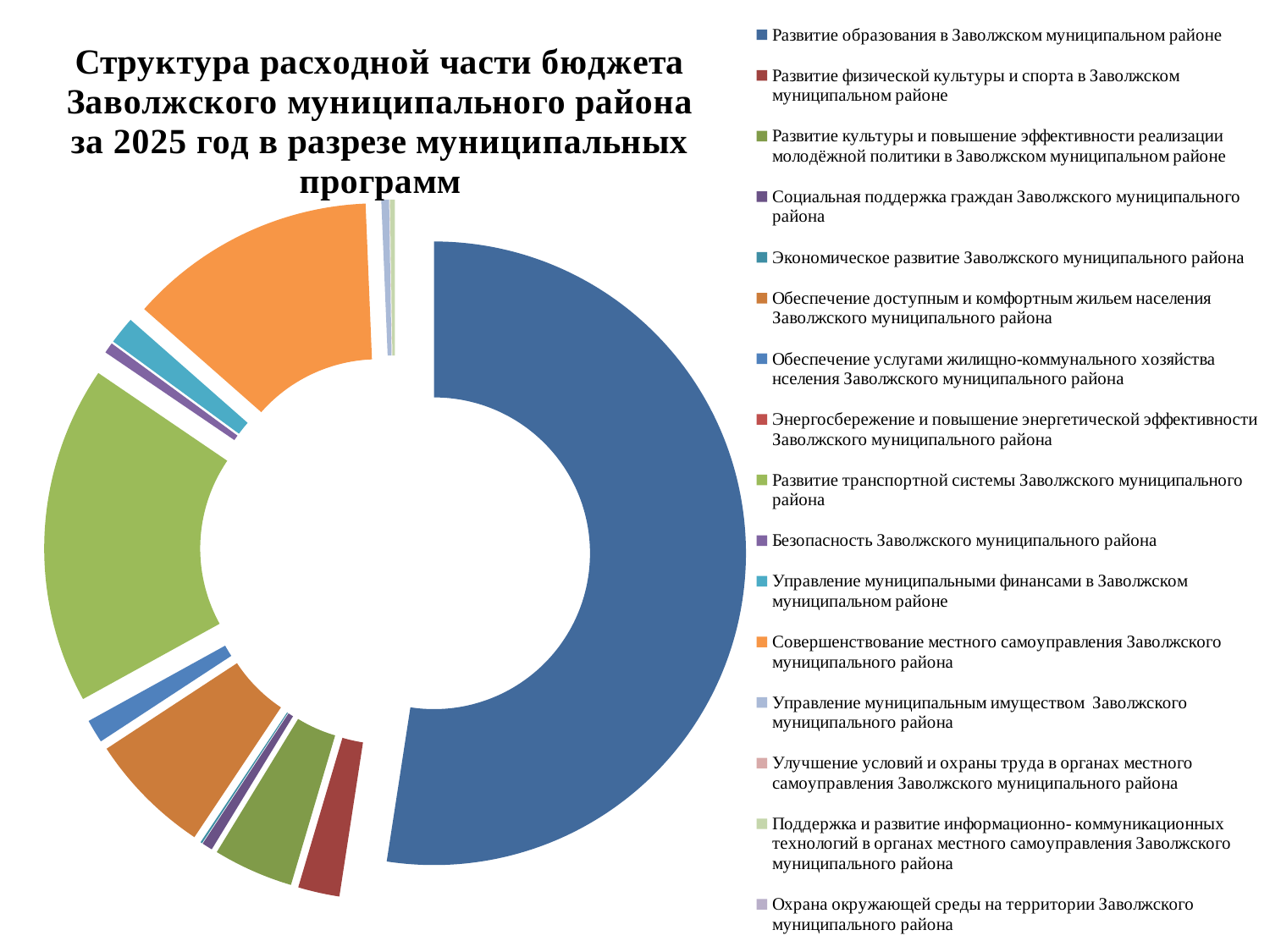
How many categories does the legend of the chart list? 16 What year does the chart title say the budget expenditure structure refers to? 2025 What colour is the slice for Развитие образования в Заволжском муниципальном районе? Blue Which is larger: the slice for Развитие транспортной системы or the slice for Совершенствование местного самоуправления? Развитие транспортной системы Which is larger: the slice for Обеспечение доступным и комфортным жильем or the slice for Энергосбережение и повышение энергетической эффективности? Обеспечение доступным и комфортным жильем Which is larger: the slice for Развитие образования or the slice for Развитие транспортной системы? Развитие образования What kind of chart is shown on the slide? Doughnut (pie) chart Which program has the second-largest slice in the chart? Развитие транспортной системы Заволжского муниципального района Which municipal program has the largest share of the budget expenditure in the chart? Развитие образования в Заволжском муниципальном районе